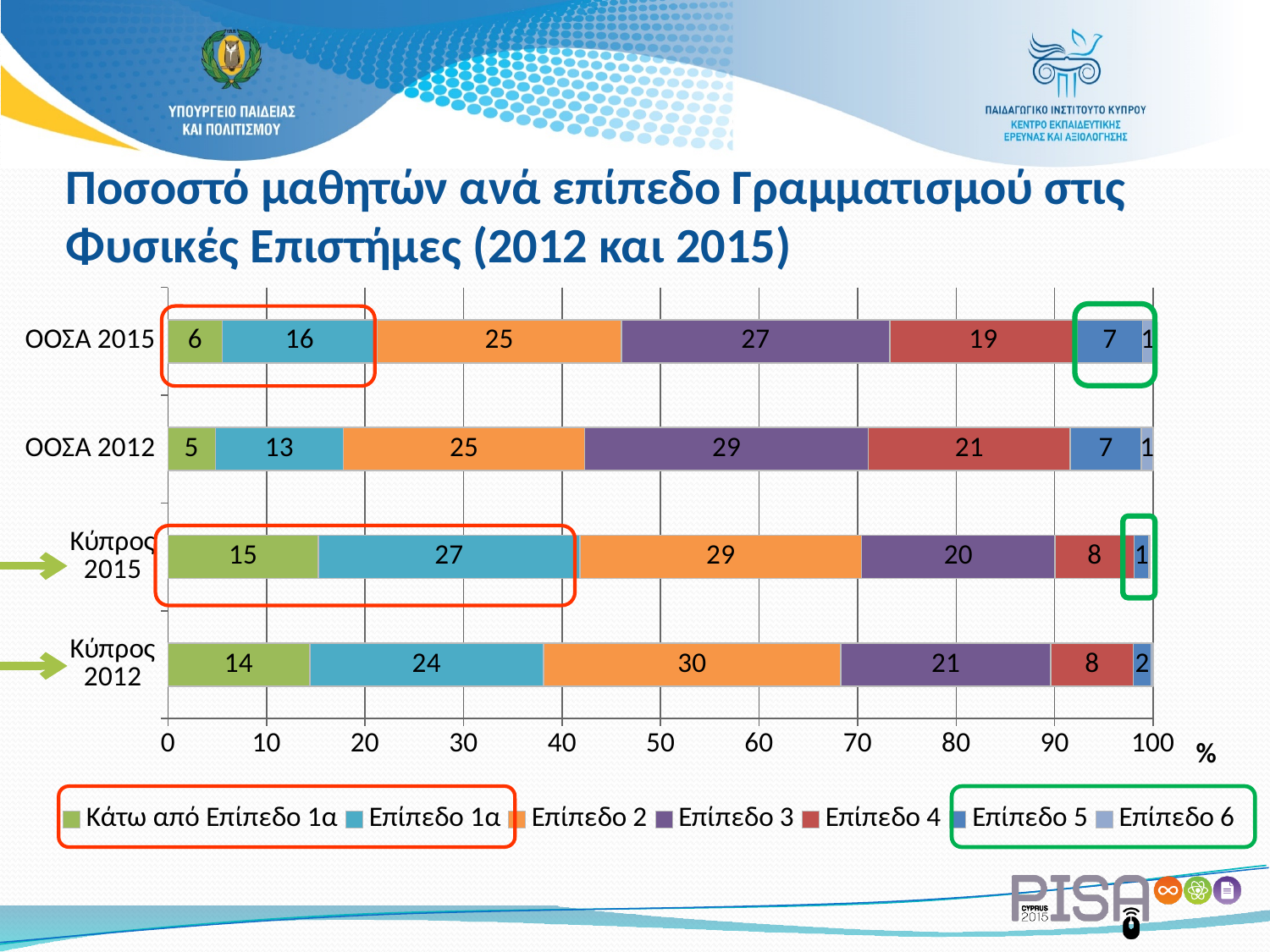
What is the value of Επίπεδο 1α for ΟΟΣΑ 2015? 16 What unit is shown at the end of the x axis? % Which category has the highest value for Κάτω από Επίπεδο 1α? Κύπρος 2015 What kind of chart is shown on the slide? Stacked bar chart What is the difference between the Επίπεδο 1α values for Κύπρος 2015 and ΟΟΣΑ 2015? 11 Which has the larger Επίπεδο 2 value, Κύπρος 2012 or ΟΟΣΑ 2012? Κύπρος 2012 What is the value of Κάτω από Επίπεδο 1α for Κύπρος 2015? 15 What is the value of Επίπεδο 2 for Κύπρος 2012? 30 How many categories (bars) are shown on the chart? 4 What is the value of Επίπεδο 4 for ΟΟΣΑ 2012? 21 How many series does the legend list? 7 Which category has the lowest value for Επίπεδο 3? Κύπρος 2015